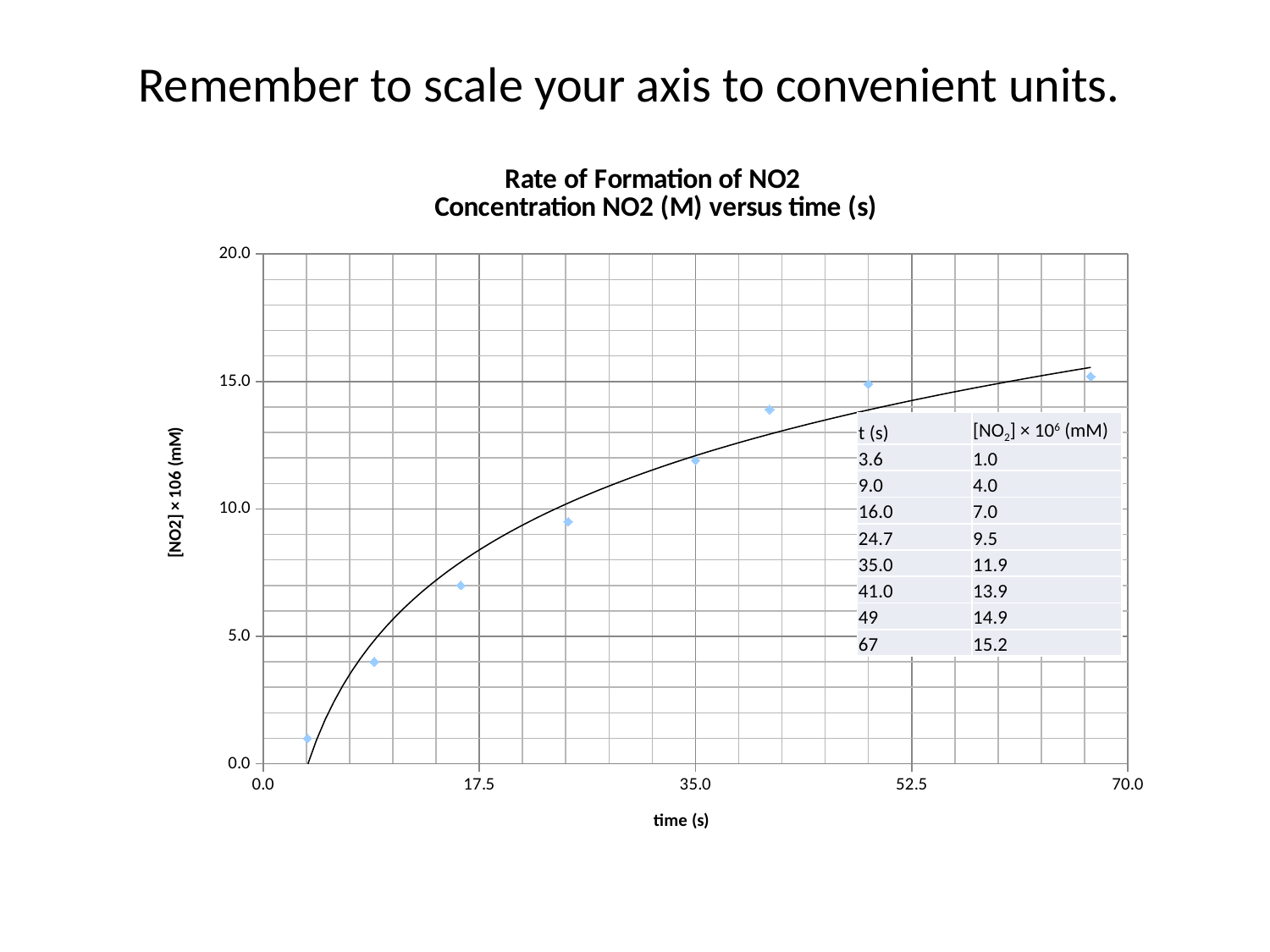
Is the concentration value at t = 24.7 s greater or less than 10.0? less According to the data table, what is the [NO2] × 10^6 (mM) value at t = 16.0 s? 7.0 According to the data table, what is the [NO2] × 10^6 (mM) value at t = 35.0 s? 11.9 What is the difference between the concentration values at t = 67 s and t = 3.6 s? 14.2 What is the title of the chart? Rate of Formation of NO2 Concentration NO2 (M) versus time (s) What is the label of the x axis? time (s) At which time (s) is the concentration value lowest? 3.6 Do the concentration values rise or fall as time increases? rise What kind of chart is shown on the slide? Scatter plot How many data points are plotted on the chart? 8 Which has the larger concentration value, t = 41.0 s or t = 35.0 s? 41.0 At which time (s) is the concentration value highest? 67